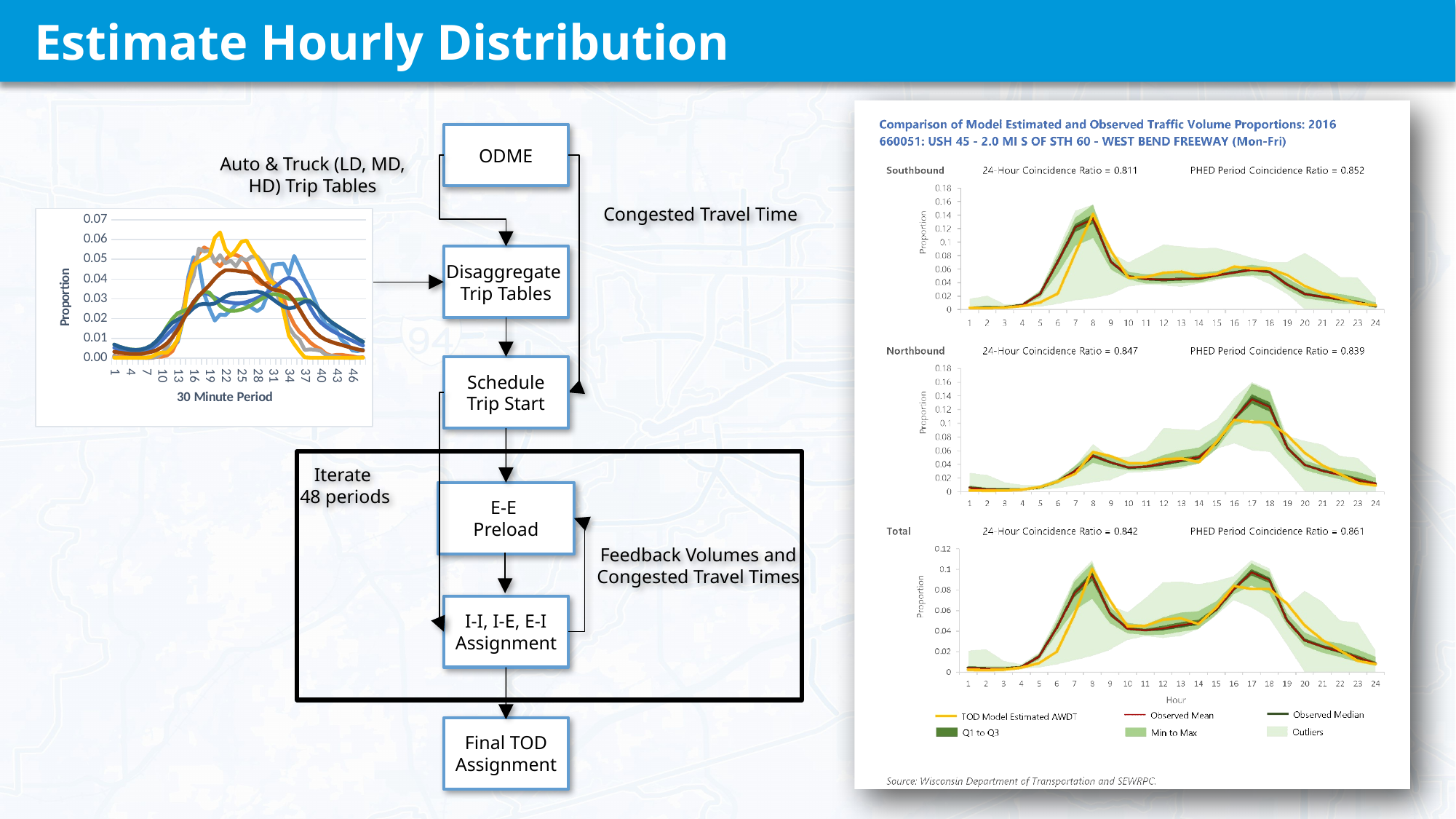
In the Southbound chart on the right, do the Observed Mean values rise or fall from hour 18 to hour 24? Fall How many hours are plotted along the x-axis of the Southbound chart on the right? 24 In the Northbound chart on the right, which is larger at hour 17: the Observed Mean or the TOD Model Estimated AWDT? Observed Mean What is the highest value shown on the y-axis of the 'Auto & Truck (LD, MD, HD) Trip Tables' chart on the left? 0.07 In the Northbound chart on the right, what is the PHED Period Coincidence Ratio? 0.839 How many entries does the legend list for the charts on the right side of the slide? 6 What kind of chart is the 'Auto & Truck (LD, MD, HD) Trip Tables' chart on the left of the slide? Line chart In the Northbound chart on the right, at which hour does the Observed Mean reach its highest value? 17 In the Southbound chart on the right, is the TOD Model Estimated AWDT value at hour 8 greater or less than 0.12? greater What is the x-axis label of the 'Auto & Truck (LD, MD, HD) Trip Tables' chart on the left? 30 Minute Period In the Total chart on the right, what is the 24-Hour Coincidence Ratio? 0.842 In the Southbound chart on the right, what is the 24-Hour Coincidence Ratio? 0.811